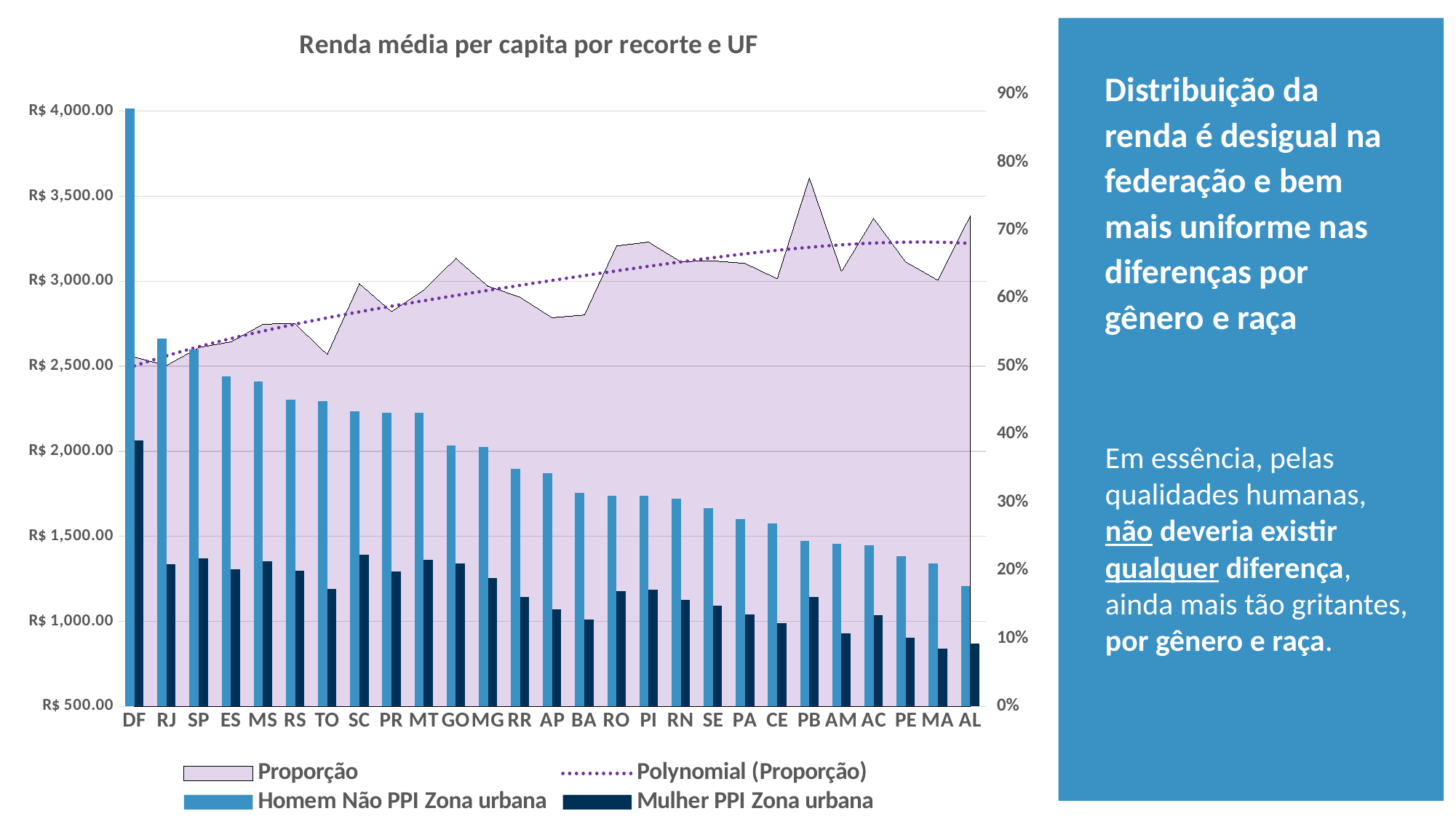
What kind of chart is shown on the slide? A combination chart with bars, an area and a dotted trend line What is the title of the chart? Renda média per capita por recorte e UF Which UF has the lowest value for Homem Não PPI Zona urbana? AL Which UF has the highest value for Mulher PPI Zona urbana? DF Is the value for Mulher PPI Zona urbana in BA greater or less than R$ 1,500.00? less Do the Homem Não PPI Zona urbana bars generally rise or fall from left to right along the x axis? fall How many series does the legend list? 4 Is the value for Homem Não PPI Zona urbana in DF greater or less than R$ 3,500.00? greater Is the Proporção value for PB greater or less than 70%? greater Which is larger, the Homem Não PPI Zona urbana value for RJ or for ES? RJ Which UF has the highest value for Homem Não PPI Zona urbana? DF How many UF categories are shown on the x axis? 27